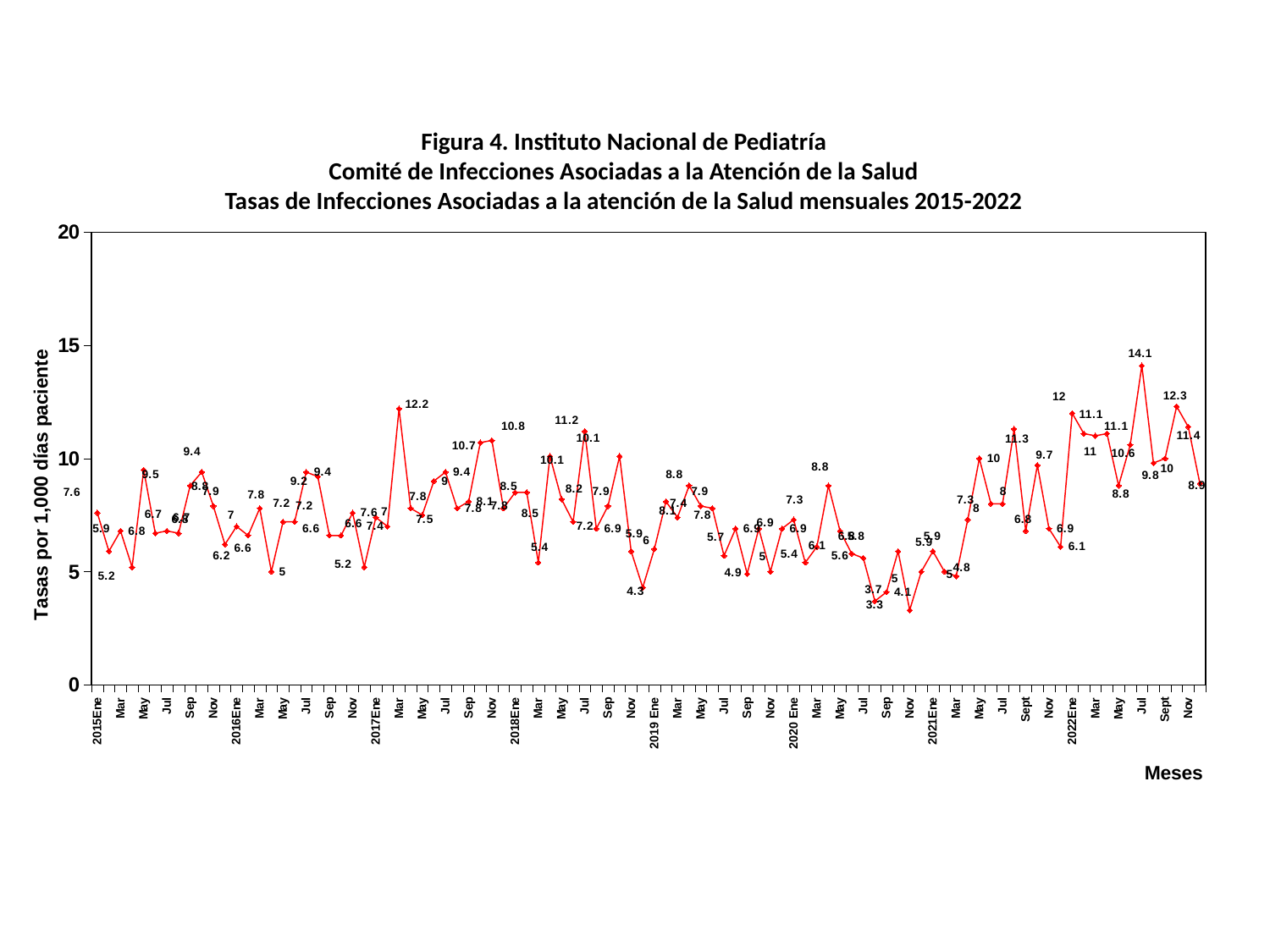
What is the rate for Sept 2022? 10 What is the rate for Mar 2017? 12.2 In which month does the chart reach its highest value? Jul 2022 Is the value for Nov 2020 greater or less than 5? less What is the rate for Jul 2018? 11.2 In which month does the chart reach its lowest value? Nov 2020 Which is larger, the rate for Jul 2022 or the rate for Mar 2017? Jul 2022 What kind of chart is shown on the slide? line chart What is the difference between the rate for Jul 2022 and the rate for Sept 2022? 4.1 What is the title of the vertical axis? Tasas por 1,000 días paciente What is the highest monthly rate plotted on the chart? 14.1 What is the lowest monthly rate plotted on the chart? 3.3